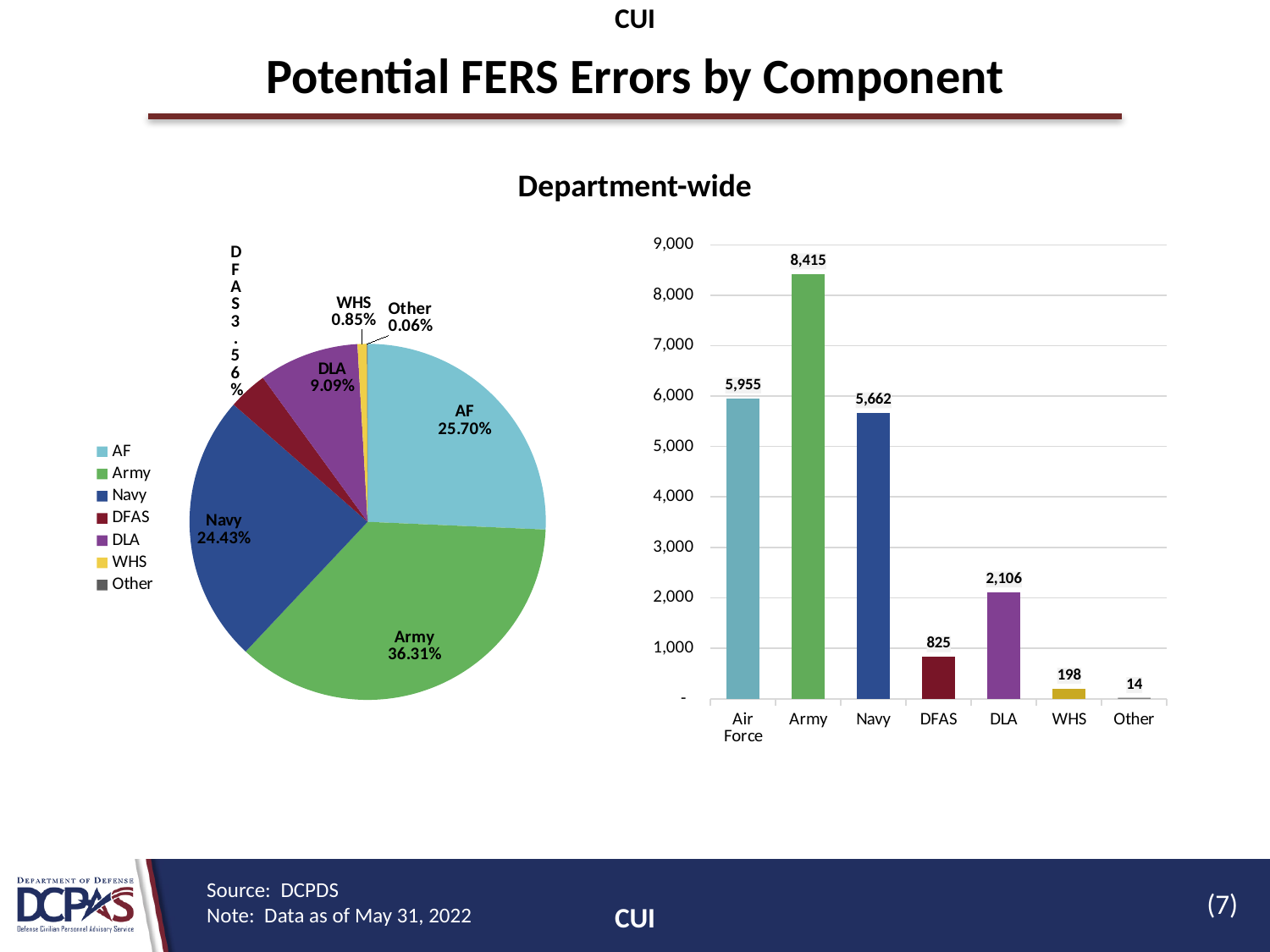
In the bar chart on the right, what is the value for DLA? 2,106 In the pie chart on the left, what share does WHS have? 0.85% In the pie chart on the left, what share does Army have? 36.31% In the pie chart on the left, which slice is the largest? Army How many categories are shown on the x axis of the bar chart on the right? 7 What kind of chart is the chart on the right of the slide? Bar chart In the bar chart on the right, which is larger, the value for DFAS or the value for WHS? DFAS How many entries does the legend of the pie chart on the left list? 7 In the bar chart on the right, what is the difference between the Air Force and Navy values? 293 In the bar chart on the right, what is the value for Army? 8,415 In the bar chart on the right, which category has the lowest value? Other In the bar chart on the right, which category has the highest value? Army